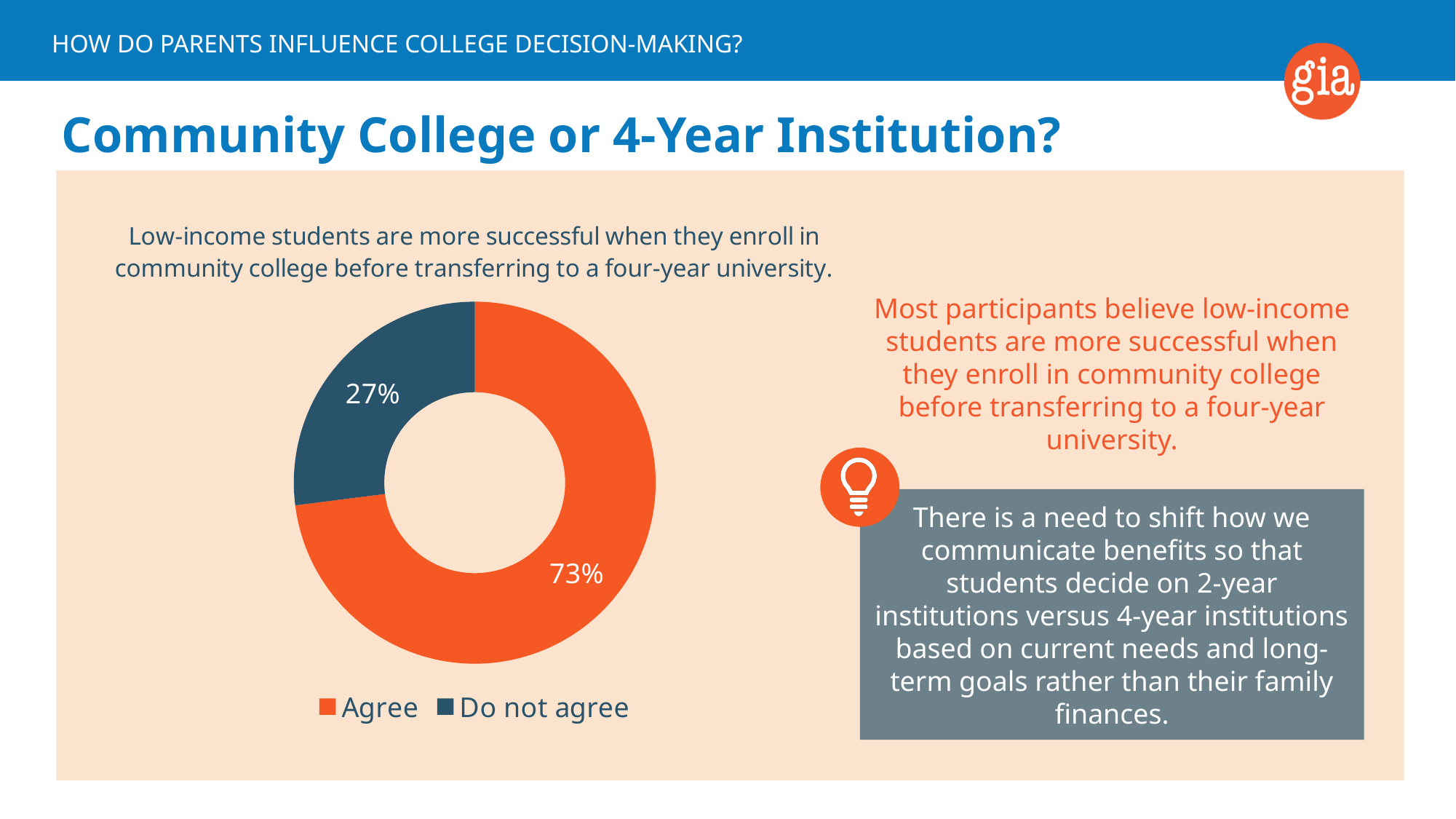
What kind of chart is shown on the slide? Pie chart (doughnut) What is the difference in percentage points between the Agree and Do not agree shares? 46 What statement were participants asked to agree or disagree with in the chart? Low-income students are more successful when they enroll in community college before transferring to a four-year university. What percentage of participants do not agree with the statement in the chart? 27% Is the share for Agree larger or smaller than the share for Do not agree? Larger What share of the pie does the Agree slice represent? 73% Which response has the larger share of the chart, Agree or Do not agree? Agree How many entries does the chart legend list? 2 What colour represents the Do not agree category in the chart? Dark blue How many categories does the chart show? 2 Which response has the smallest share of the chart? Do not agree What percentage of participants agree that low-income students are more successful when they enroll in community college before transferring to a four-year university? 73%